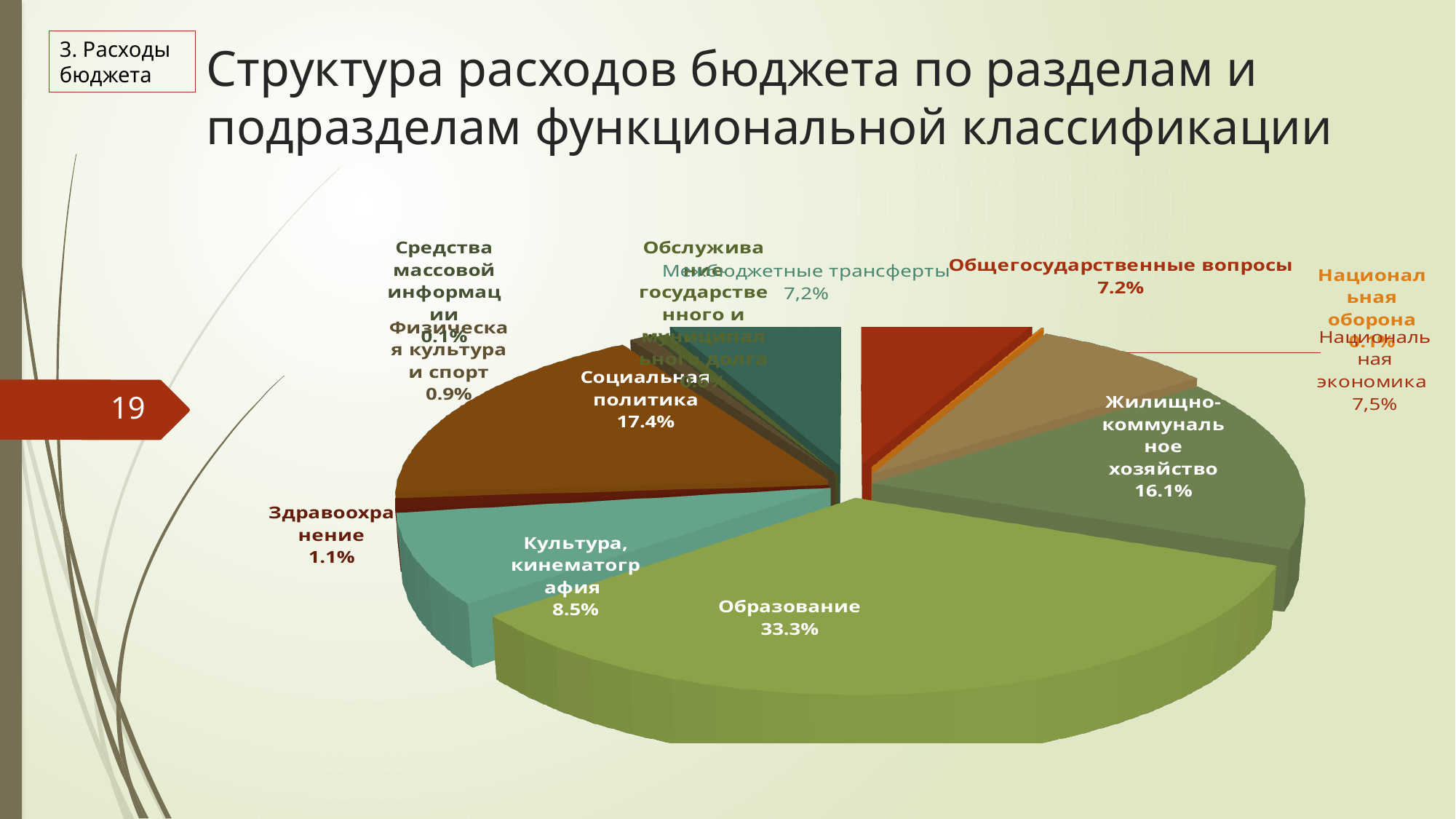
Which is larger, the share for Социальная политика or for Жилищно-коммунальное хозяйство? Социальная политика What is the value for Культура, кинематография? 8.5% What share is shown for Здравоохранение? 1.1% What percentage is shown for Жилищно-коммунальное хозяйство? 16.1% What is the value for Физическая культура и спорт? 0.9% Which section has the largest share of budget expenditure? Образование What kind of chart is shown on the slide? pie chart What is the title of the slide containing the chart? Структура расходов бюджета по разделам и подразделам функциональной классификации By how many percentage points does Образование exceed Социальная политика? 15.9 What percentage is shown for Национальная экономика? 7,5% What share of budget expenditure goes to Образование? 33.3% What is the value shown for Социальная политика? 17.4%